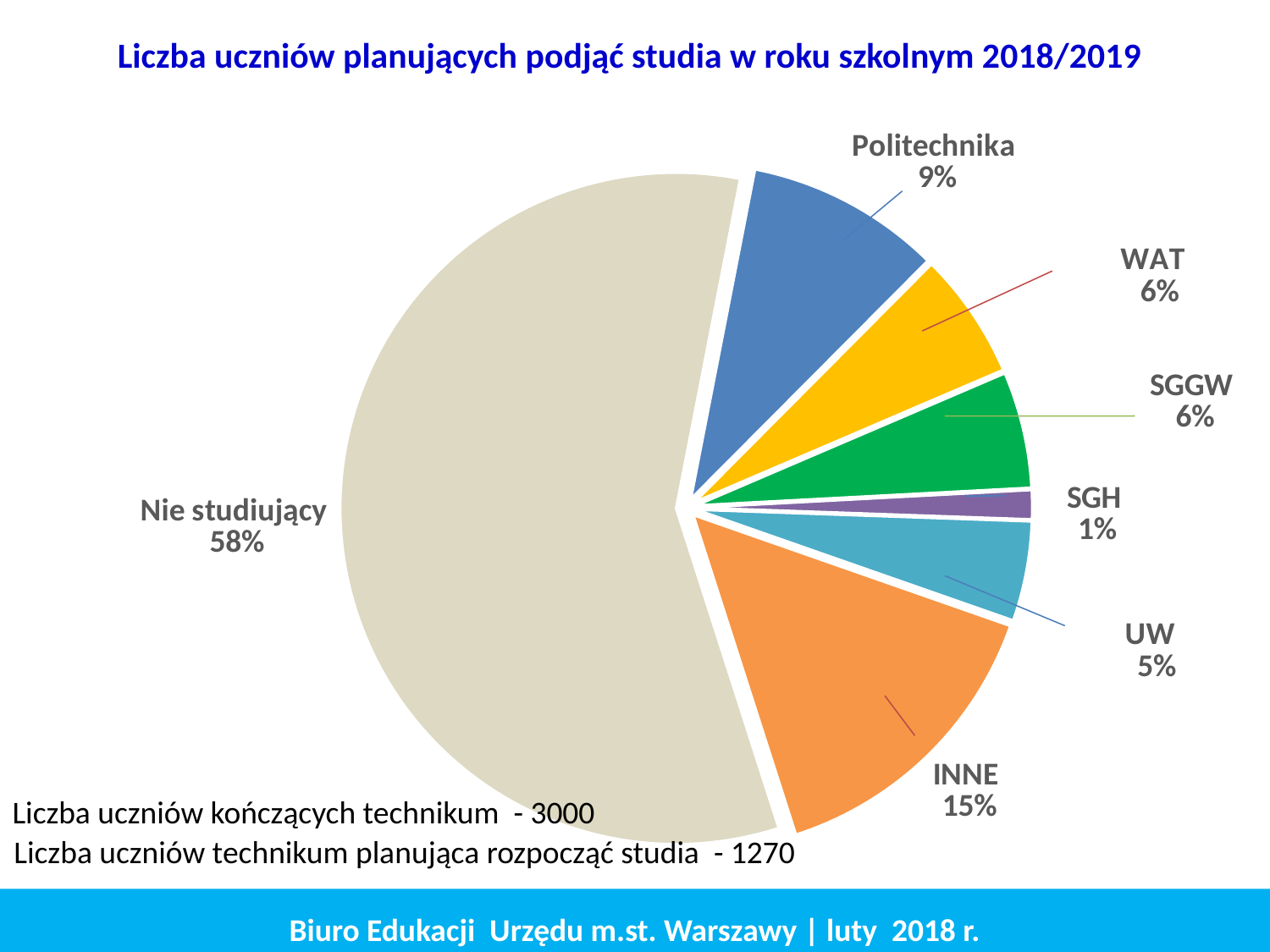
What is the title of the chart? Liczba uczniów planujących podjąć studia w roku szkolnym 2018/2019 How many slices does the pie chart have? 7 Which slice of the pie is the largest? Nie studiujący What share of the pie does INNE have? 15% Which slice of the pie is the smallest? SGH What kind of chart is shown on the slide? pie chart What is the value shown for SGH? 1% Which is larger, the share for WAT or the share for UW? WAT What is the value shown for UW? 5% What share of the pie does Nie studiujący have? 58% What share of the pie does Politechnika have? 9% What is the difference between the shares of INNE and Politechnika? 6%